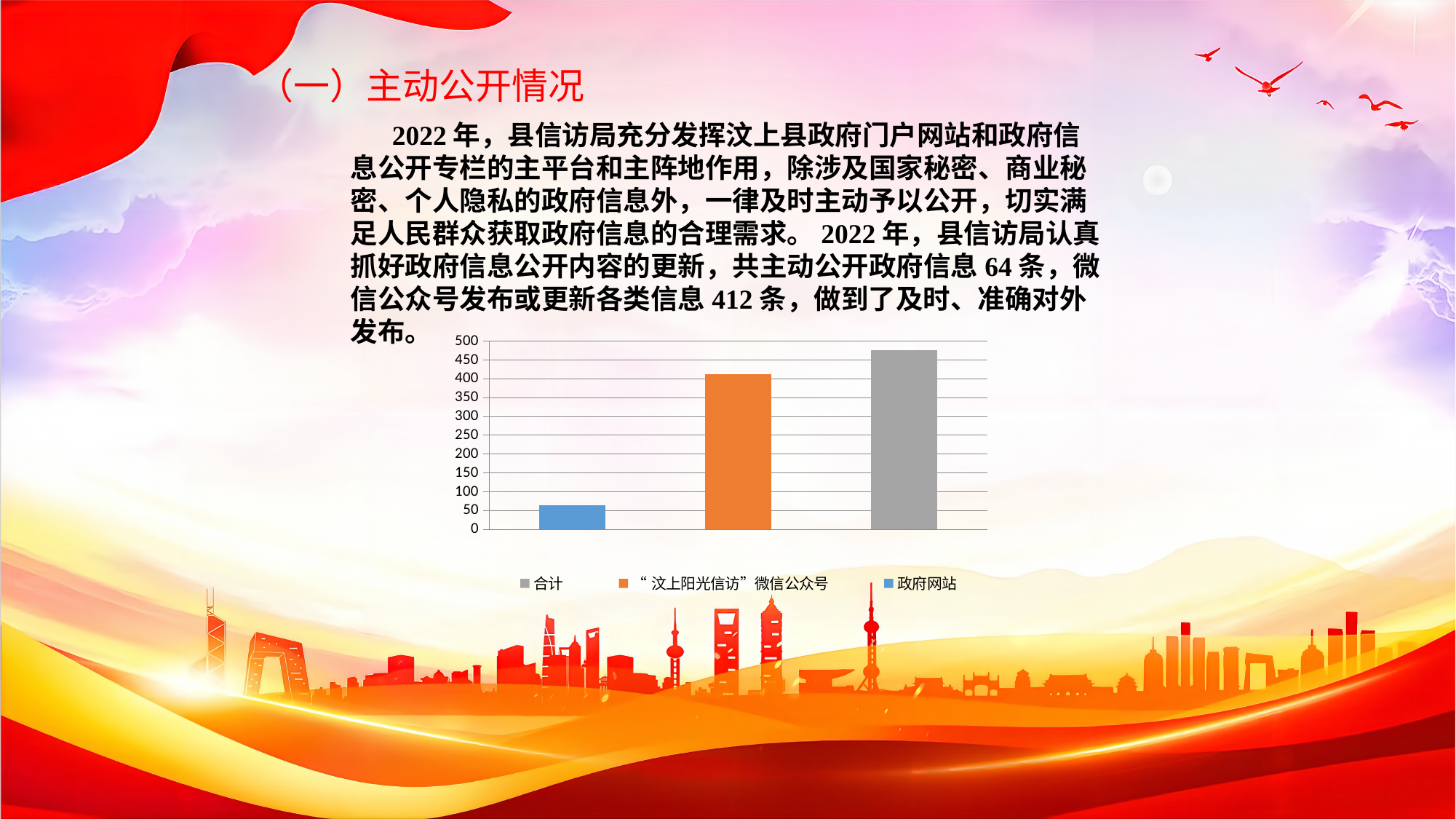
Which is larger, the value for “汶上阳光信访”微信公众号 or the value for 政府网站? “汶上阳光信访”微信公众号 What colour is the bar for 合计 in the chart? gray Is the value for “汶上阳光信访”微信公众号 greater or less than 450? less Is the value for 政府网站 greater or less than 100? less How many bars are plotted in the chart? 3 Which series has the shortest bar in the chart? 政府网站 Is the value for 合计 greater or less than 450? greater What kind of chart is shown on the slide? bar chart Which series has the tallest bar in the chart? 合计 How many series does the chart legend list? 3